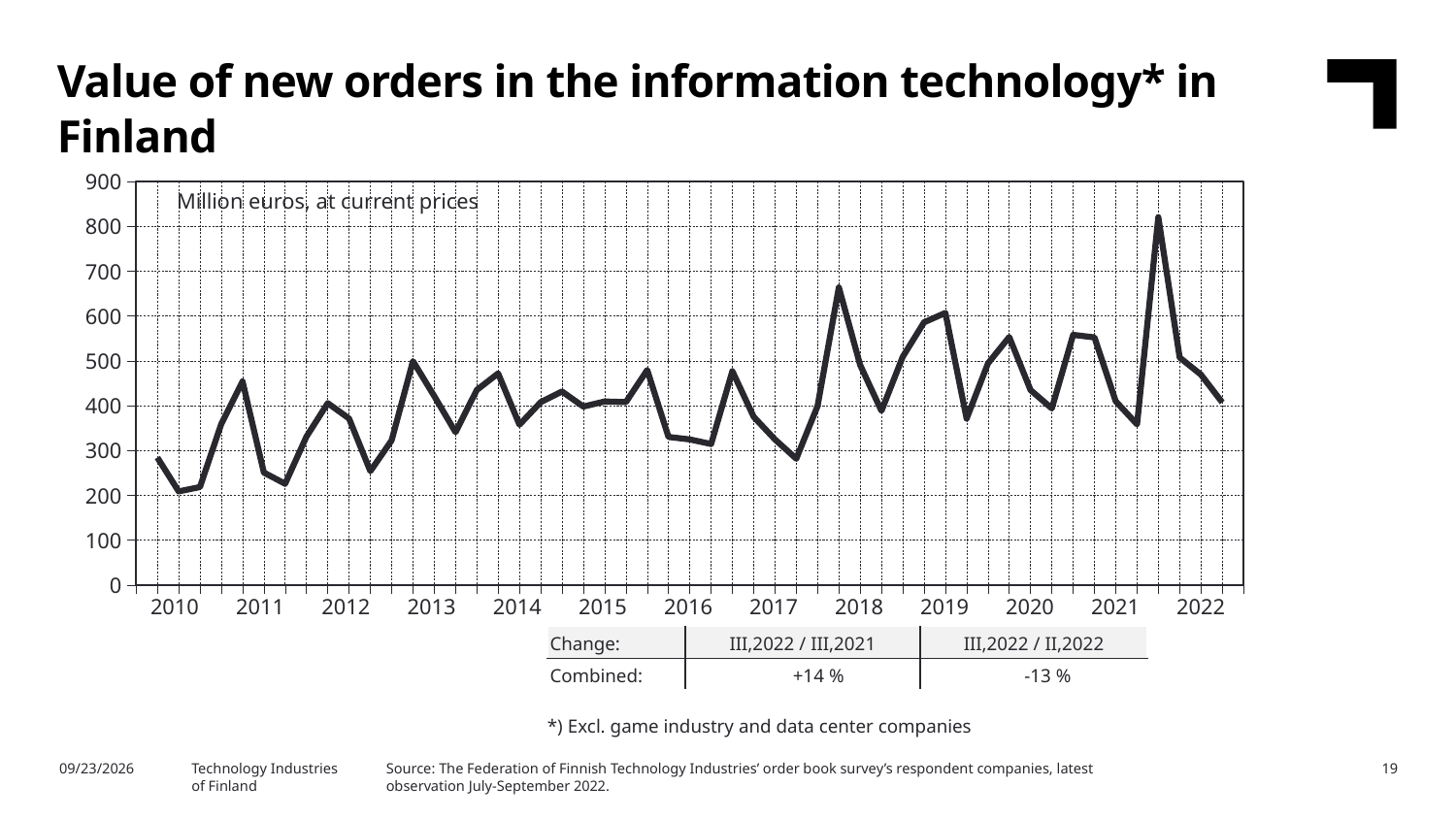
Is the highest peak of the line, in 2021, greater or less than 700? greater Is the first plotted value, at the start of 2010, greater or less than 300? less According to the table below the chart, what is the combined change for III,2022 / III,2021? +14 % Is the peak in 2021 higher or lower than the peak in 2018? higher How many years are labelled on the x axis? 13 Is the peak value reached in 2018 greater or less than 600? greater What kind of chart is shown on the slide? line chart In what unit are the values on the chart expressed, according to the label inside the plot area? Million euros, at current prices Does the line rise or fall from its 2021 peak to the end of 2022? fall What is the title of the chart on the slide? Value of new orders in the information technology* in Finland In which year does the line reach its highest peak? 2021